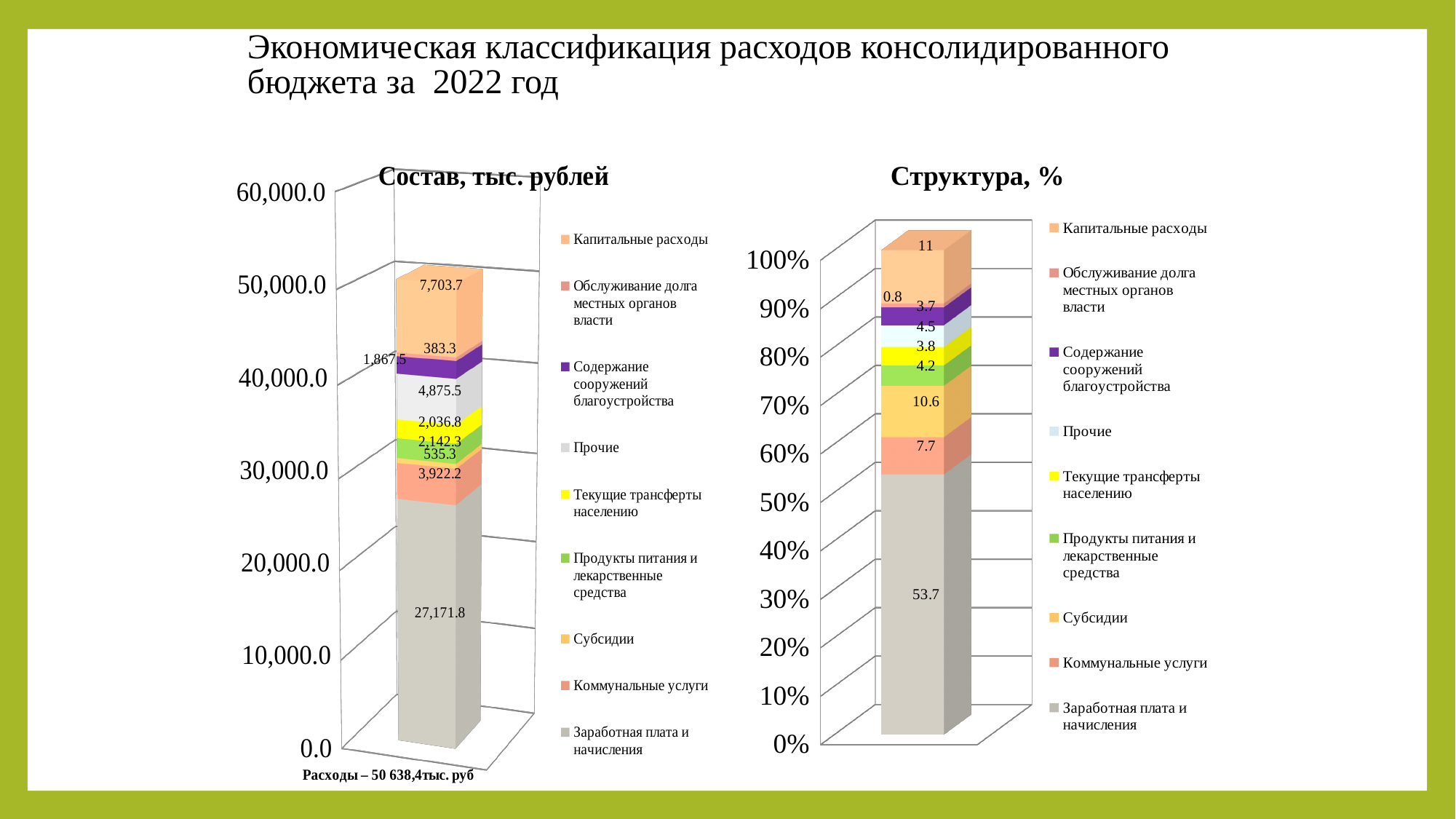
In the chart titled "Структура, %", what is the value for Прочие? 4.5 In the chart titled "Состав, тыс. рублей", which category has the largest value? Заработная плата и начисления In the chart titled "Структура, %", which is larger: Капитальные расходы or Субсидии? Капитальные расходы In the chart titled "Состав, тыс. рублей", what is the value for Обслуживание долга местных органов власти? 383.3 How many series does the legend of the chart titled "Структура, %" list? 9 In the chart titled "Состав, тыс. рублей", what is the value for Капитальные расходы? 7,703.7 In the chart titled "Структура, %", which category has the smallest value? Обслуживание долга местных органов власти In the chart titled "Состав, тыс. рублей", what is the total of the stacked bar? 50 638,4 In the chart titled "Состав, тыс. рублей", what is the difference between Коммунальные услуги and Субсидии? 3,386.9 What kind of chart is the chart titled "Состав, тыс. рублей"? Stacked bar chart In the chart titled "Состав, тыс. рублей", what is the value for Заработная плата и начисления? 27,171.8 In the chart titled "Структура, %", what is the value for Субсидии? 10.6